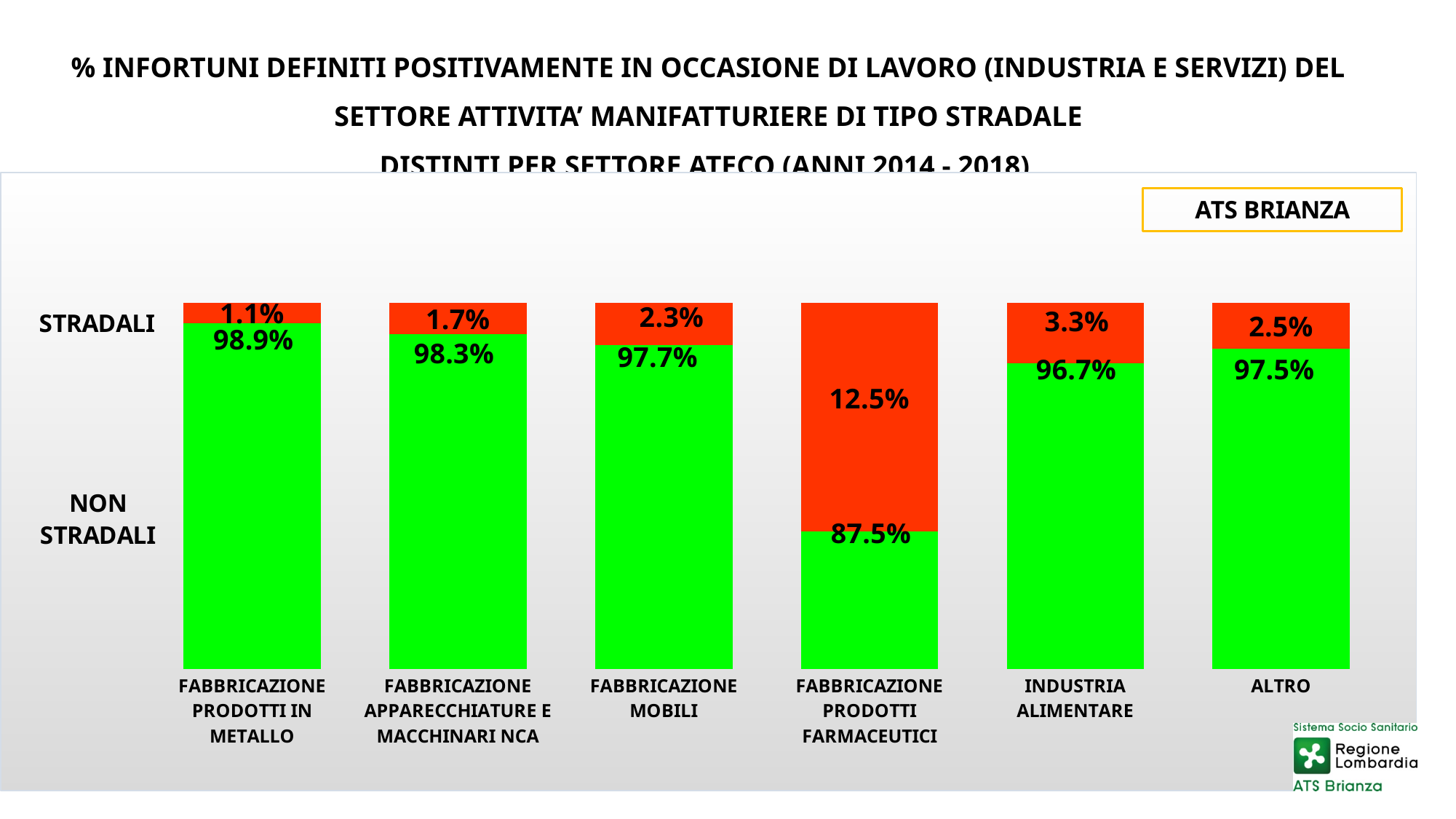
What is the STRADALI percentage for INDUSTRIA ALIMENTARE? 3.3% What kind of chart is shown? Stacked bar chart Which sector has the highest STRADALI percentage? FABBRICAZIONE PRODOTTI FARMACEUTICI Which sector has the lowest STRADALI percentage? FABBRICAZIONE PRODOTTI IN METALLO How many series does the chart show? 2 What is the total of the STRADALI and NON STRADALI percentages for FABBRICAZIONE APPARECCHIATURE E MACCHINARI NCA? 100% What is the difference between the STRADALI percentages of FABBRICAZIONE PRODOTTI FARMACEUTICI and FABBRICAZIONE MOBILI? 10.2% What is the NON STRADALI percentage for ALTRO? 97.5% What is the STRADALI percentage for FABBRICAZIONE PRODOTTI FARMACEUTICI? 12.5% Which has a larger STRADALI percentage, INDUSTRIA ALIMENTARE or ALTRO? INDUSTRIA ALIMENTARE How many sectors are shown on the x axis? 6 What is the NON STRADALI percentage for FABBRICAZIONE PRODOTTI IN METALLO? 98.9%